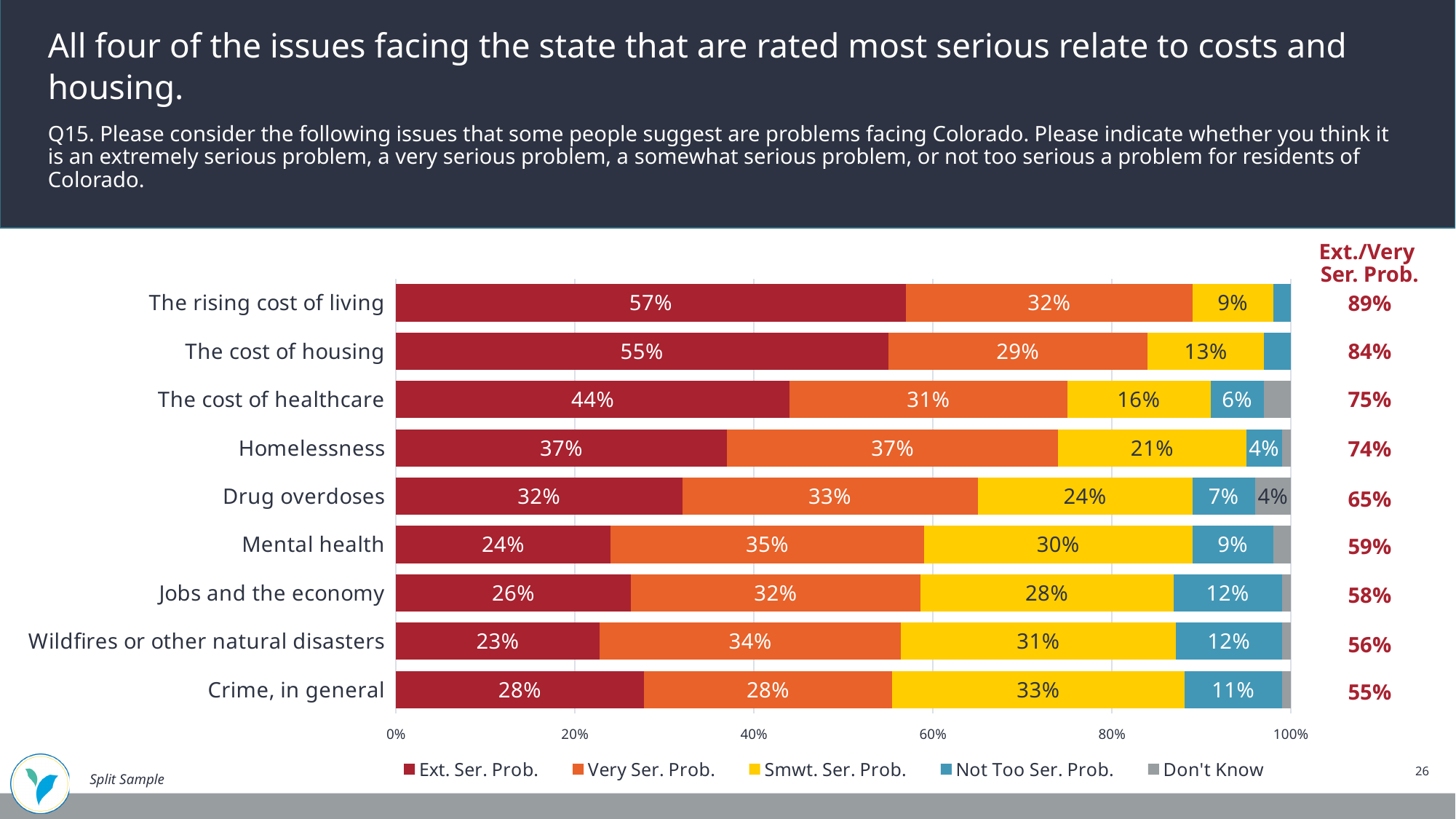
What is the Smwt. Ser. Prob. value for Crime, in general? 33% How many percentage points higher is the Ext. Ser. Prob. value for the rising cost of living than for the cost of housing? 2 percentage points What is the combined Ext./Very Ser. Prob. value shown for Drug overdoses? 65% How many series does the legend list? 5 Which issue has the lowest Ext. Ser. Prob. percentage? Wildfires or other natural disasters What percentage rated the cost of healthcare an extremely serious problem (Ext. Ser. Prob.)? 44% What kind of chart is shown on the slide? Stacked bar chart What is the Very Ser. Prob. value for Homelessness? 37% How many issues are listed in the chart? 9 What is the Not Too Ser. Prob. value for Jobs and the economy? 12% Which has the larger Smwt. Ser. Prob. value, Mental health or Jobs and the economy? Mental health Which issue has the highest Ext. Ser. Prob. percentage? The rising cost of living